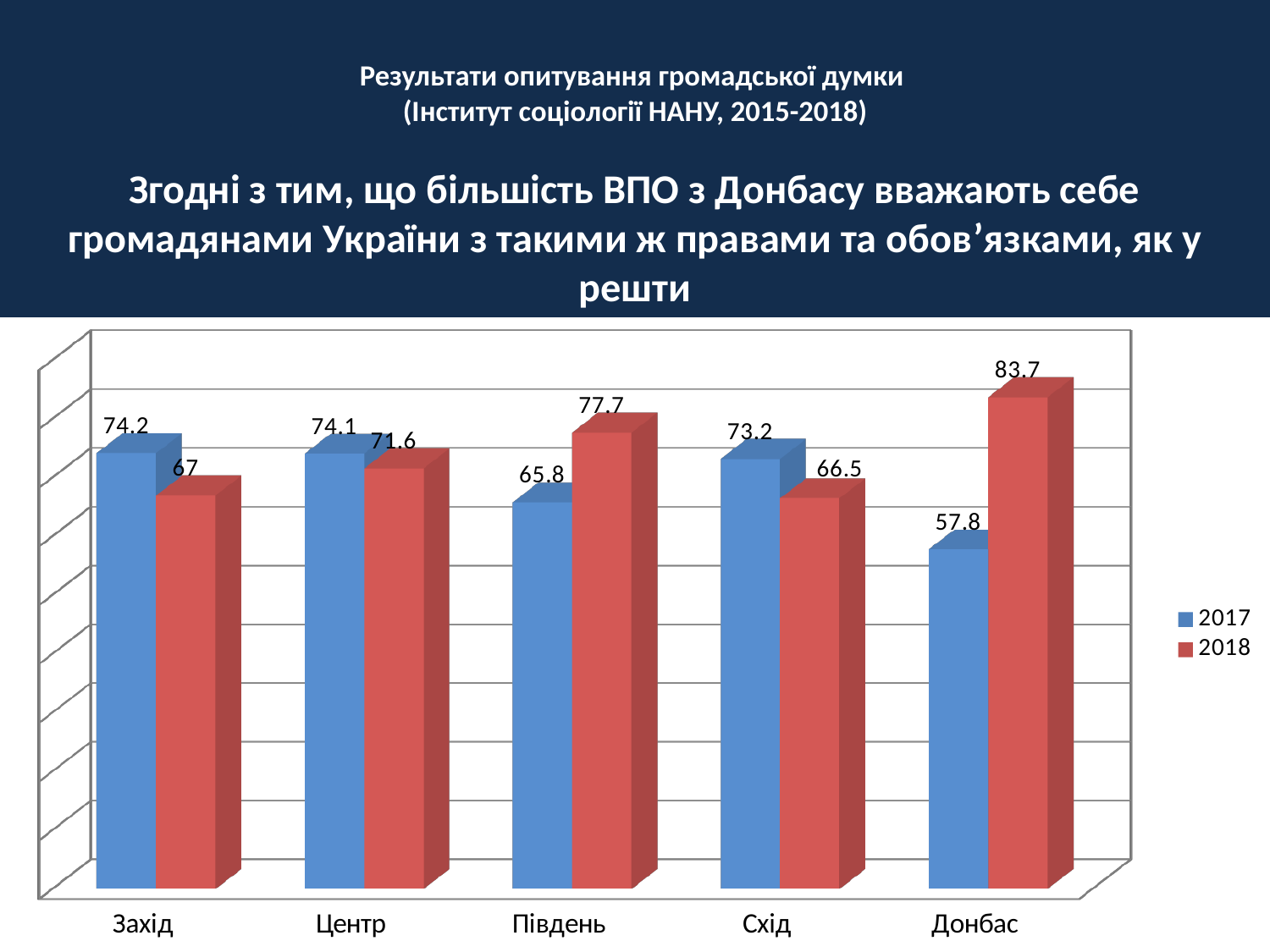
For Південь, which is larger: the 2017 value or the 2018 value? 2018 Which region has the highest value in the 2018 series? Донбас What kind of chart is shown on the slide? Bar chart How many regions are shown on the x axis? 5 What is the difference between the 2017 and 2018 values for Захід? 7.2 What is the value for Південь in the 2018 series? 77.7 What is the value for Схід in the 2017 series? 73.2 What is the difference between the 2018 and 2017 values for Донбас? 25.9 Which region has the lowest value in the 2017 series? Донбас What is the value for Донбас in the 2018 series? 83.7 What is the value for Захід in the 2017 series? 74.2 How many series does the legend list? 2